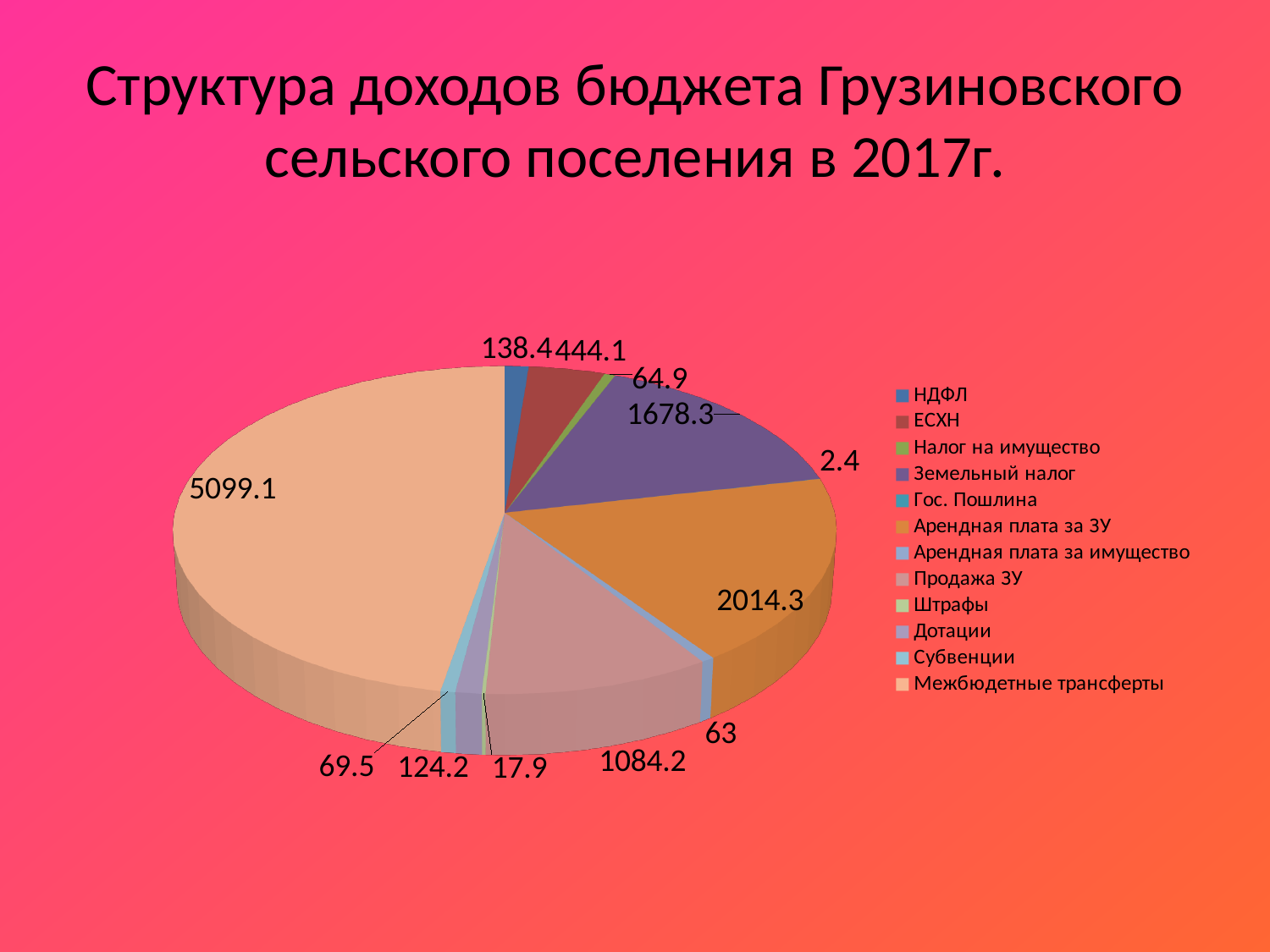
What is the title of the slide? Структура доходов бюджета Грузиновского сельского поселения в 2017г. What is the value for Гос. Пошлина? 2.4 What is the value for Продажа ЗУ? 1084.2 What is the value for Арендная плата за ЗУ? 2014.3 What is the value for Межбюдетные трансферты? 5099.1 How many categories does the legend list? 12 What is the value for Земельный налог? 1678.3 Which category has the smallest slice of the pie? Гос. Пошлина What type of chart is shown on the slide? Pie chart Which is larger, ЕСХН or НДФЛ? ЕСХН Which category has the largest slice of the pie? Межбюдетные трансферты What is the difference between the values for Арендная плата за ЗУ and Земельный налог? 336